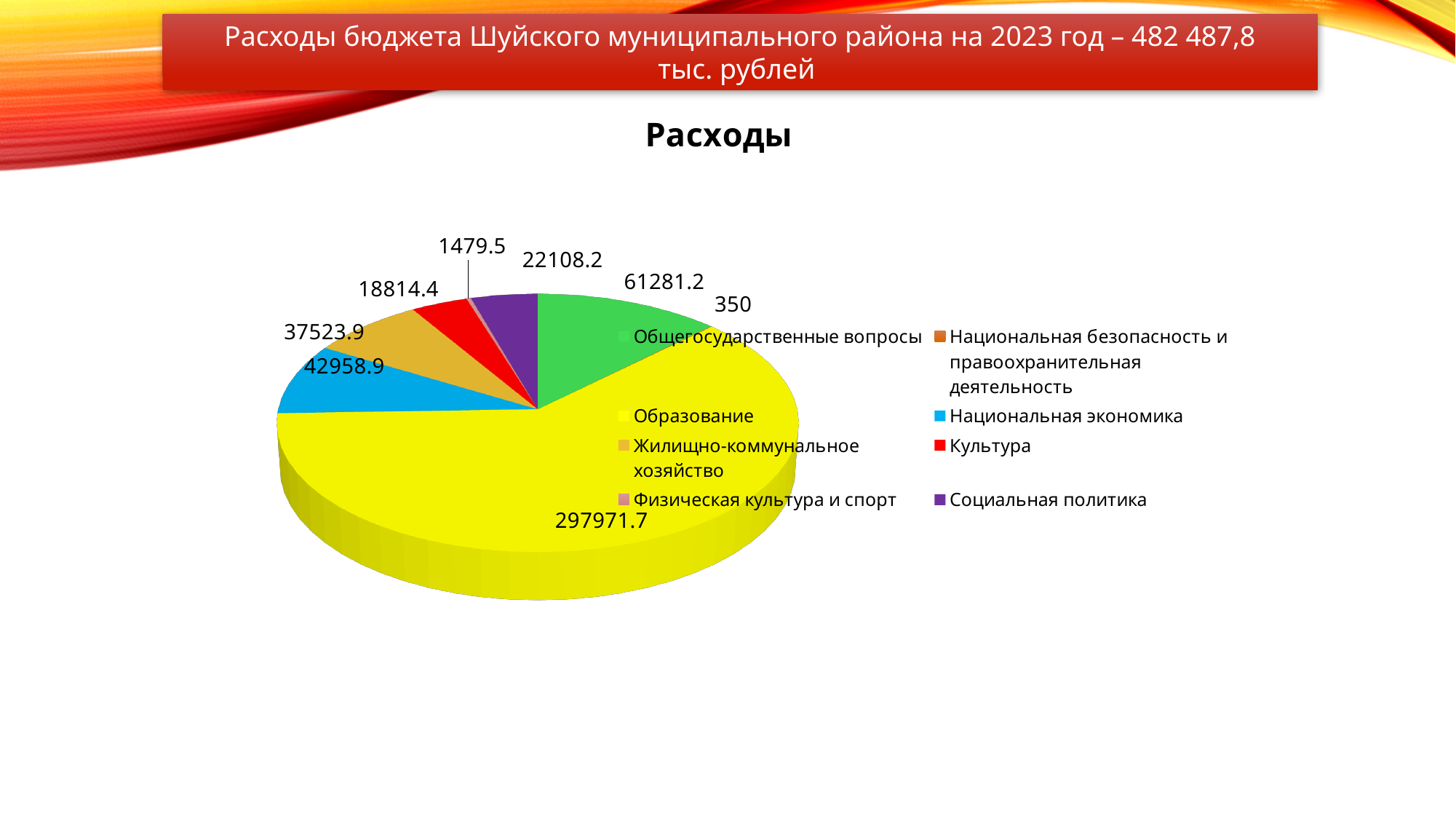
How many categories does the pie chart show? 8 What is the difference between the values for Общегосударственные вопросы and Национальная экономика? 18322.3 Which category has the smallest value? Национальная безопасность и правоохранительная деятельность What is the value for Культура? 18814.4 What kind of chart is shown on the slide? pie chart Which is larger: Национальная экономика or Жилищно-коммунальное хозяйство? Национальная экономика What is the value for Социальная политика? 22108.2 Which category has the largest slice of the pie? Образование What is the value for Национальная экономика? 42958.9 What is the value for Общегосударственные вопросы? 61281.2 What is the value for Образование? 297971.7 What is the title of the chart? Расходы